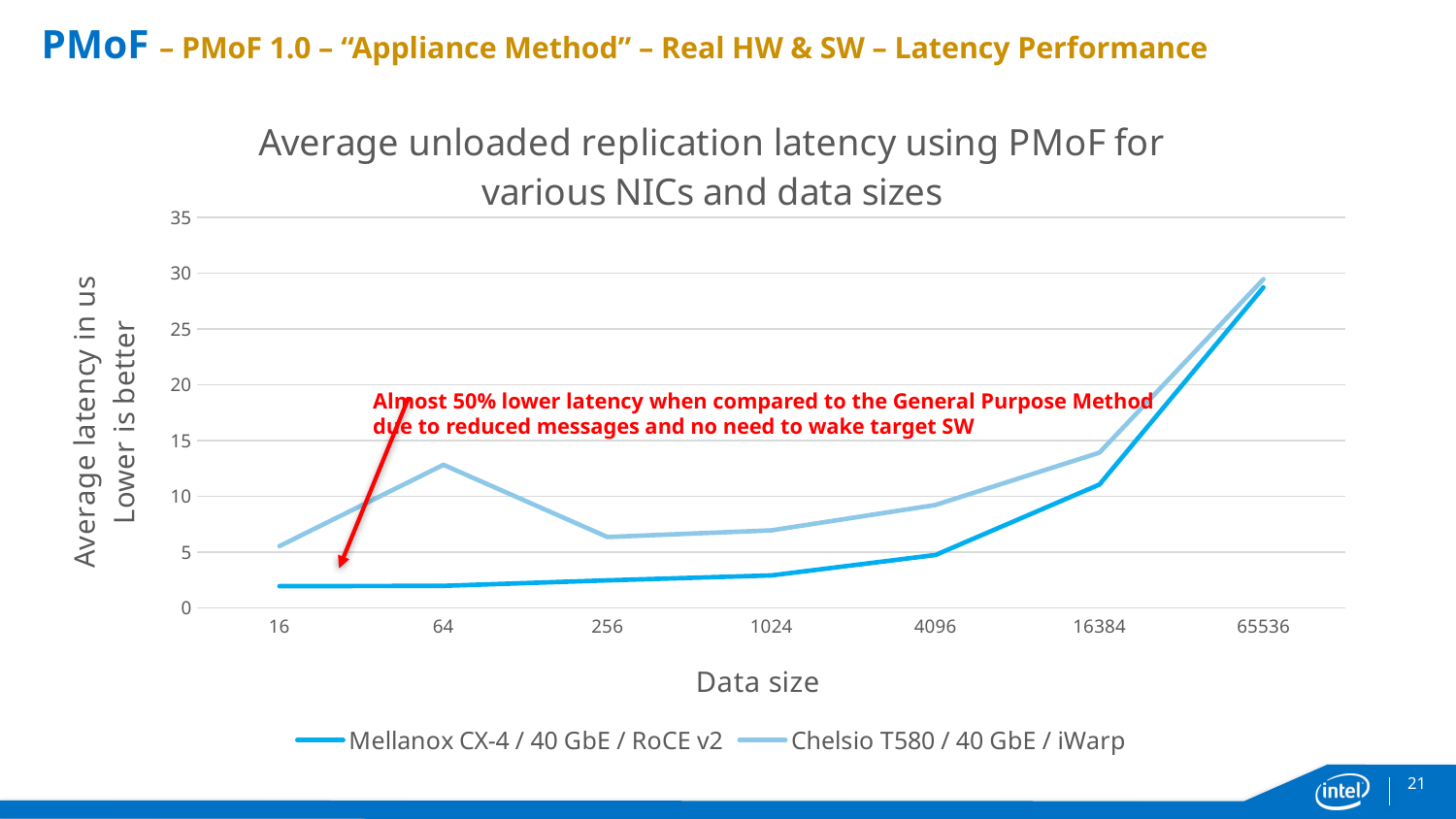
At which data size does the Mellanox CX-4 / 40 GbE / RoCE v2 series reach its highest latency? 65536 Does the Mellanox CX-4 / 40 GbE / RoCE v2 series rise or fall as data size increases from 4096 to 65536? rise At which data size does the Chelsio T580 / 40 GbE / iWarp series have its lowest latency? 16 How many data sizes are shown on the x axis? 7 At data size 64, which series has the higher latency, Mellanox CX-4 / 40 GbE / RoCE v2 or Chelsio T580 / 40 GbE / iWarp? Chelsio T580 / 40 GbE / iWarp What is the label of the y axis? Average latency in us Lower is better Is the value for Mellanox CX-4 / 40 GbE / RoCE v2 at data size 1024 greater or less than 5? less How many series does the legend list? 2 What kind of chart is shown on the slide? line chart Is the value for Mellanox CX-4 / 40 GbE / RoCE v2 at data size 65536 greater or less than 25? greater Is the value for Chelsio T580 / 40 GbE / iWarp at data size 64 greater or less than 10? greater